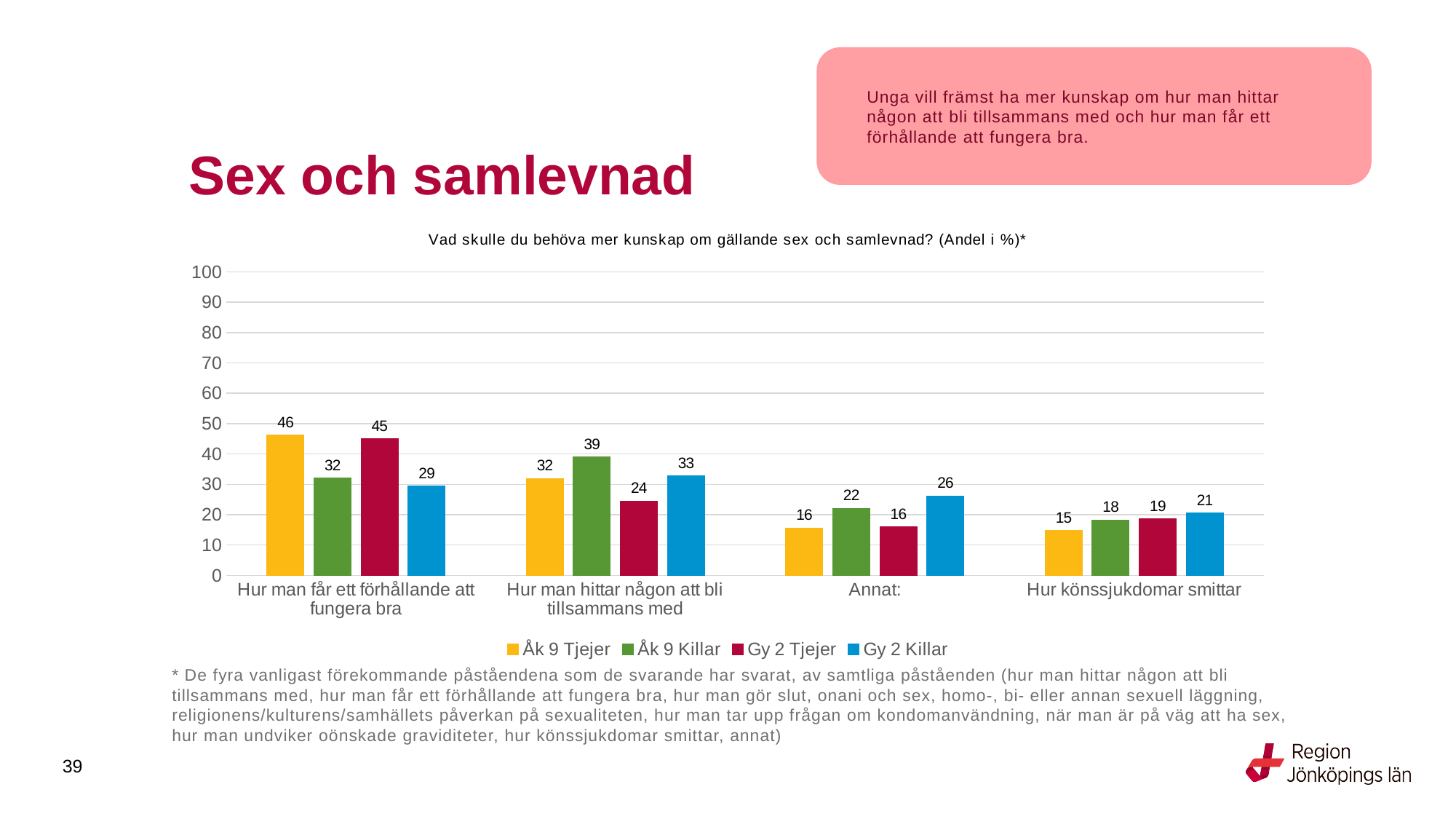
How many categories are shown on the x axis? 4 What is the value for Åk 9 Tjejer in the category "Hur man får ett förhållande att fungera bra"? 46 What is the title of the chart? Vad skulle du behöva mer kunskap om gällande sex och samlevnad? (Andel i %)* Is the value for Gy 2 Tjejer in "Hur man får ett förhållande att fungera bra" greater or less than 40? greater Which series has the highest value in the category "Hur man hittar någon att bli tillsammans med"? Åk 9 Killar What is the value for Gy 2 Killar in the category "Annat:"? 26 What kind of chart is shown on the slide? Bar chart Which series has the lowest value in the category "Hur könssjukdomar smittar"? Åk 9 Tjejer What is the difference between the Åk 9 Tjejer and Gy 2 Killar values in the category "Hur man får ett förhållande att fungera bra"? 17 Which is larger in the category "Annat:": the value for Åk 9 Killar or the value for Gy 2 Tjejer? Åk 9 Killar How many series does the legend list? 4 What is the value for Gy 2 Tjejer in the category "Hur man hittar någon att bli tillsammans med"? 24